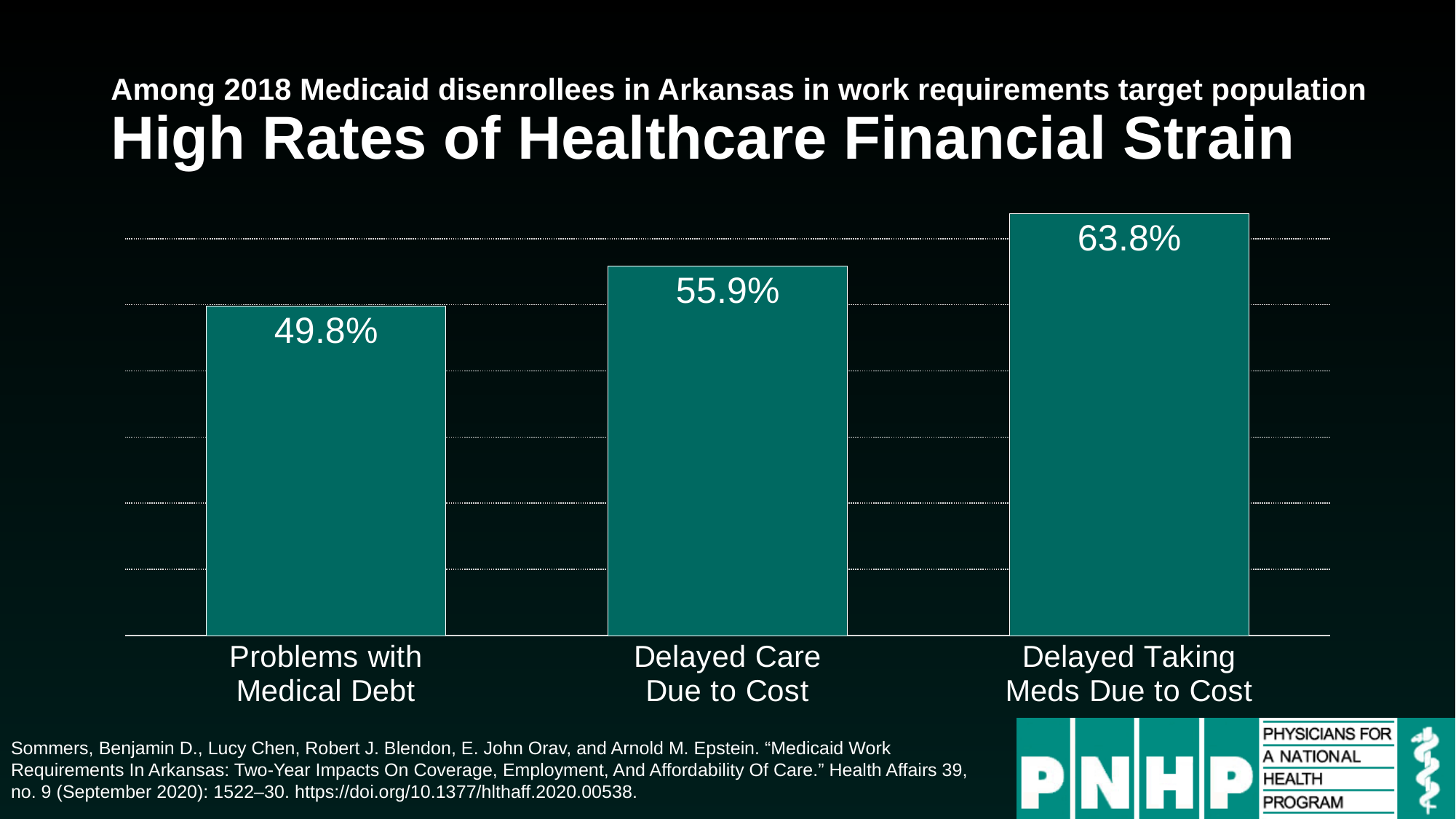
Do the values rise or fall from left to right across the categories? Rise What is the main title of the chart on the slide? High Rates of Healthcare Financial Strain What is the value for Delayed Taking Meds Due to Cost? 63.8% What is the difference between the values for Delayed Taking Meds Due to Cost and Problems with Medical Debt? 14.0% Which category has the lowest value? Problems with Medical Debt How many categories are shown in the chart? 3 Which category has the highest value? Delayed Taking Meds Due to Cost What kind of chart is shown on the slide? Bar chart What is the value for Problems with Medical Debt? 49.8% What is the difference between the values for Delayed Care Due to Cost and Problems with Medical Debt? 6.1% Which is larger, the value for Delayed Care Due to Cost or the value for Problems with Medical Debt? Delayed Care Due to Cost What is the value for Delayed Care Due to Cost? 55.9%